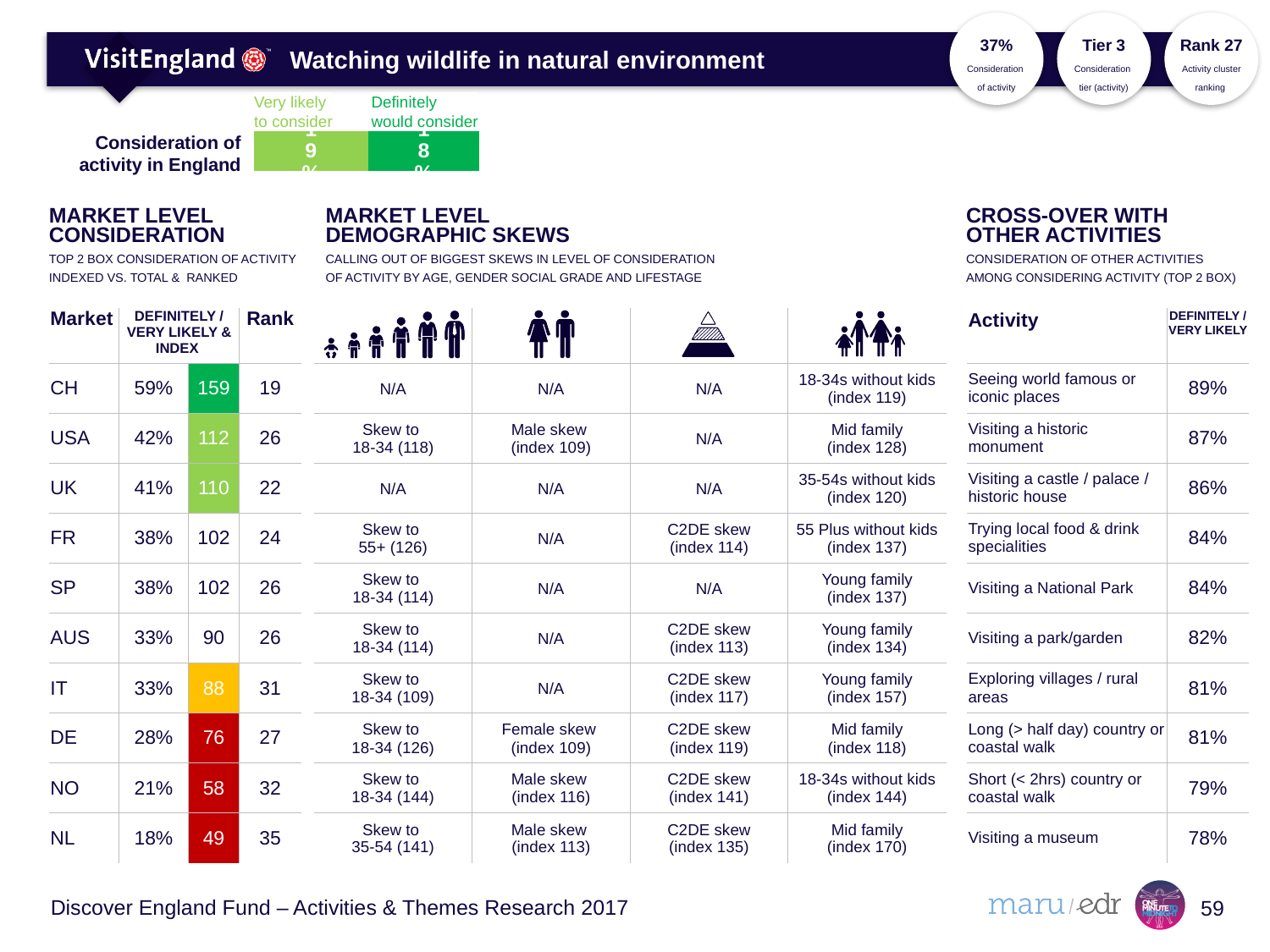
In the 'Consideration of activity in England' chart, which segment is larger: 'Very likely to consider' or 'Definitely would consider'? Very likely to consider What kind of chart is the 'Consideration of activity in England' chart? bar chart How many segments does the 'Consideration of activity in England' bar have? 2 In the 'Consideration of activity in England' chart, which segment is shown in the darker green? Definitely would consider In the 'Consideration of activity in England' chart, what is the total of the two segments? 37% In the 'Consideration of activity in England' chart, what is the difference between 'Very likely to consider' and 'Definitely would consider'? 1% In the 'Consideration of activity in England' chart, what is the value for 'Definitely would consider'? 18% What are the two segment labels in the 'Consideration of activity in England' chart? Very likely to consider; Definitely would consider In the 'Consideration of activity in England' chart, what is the value for 'Very likely to consider'? 19%